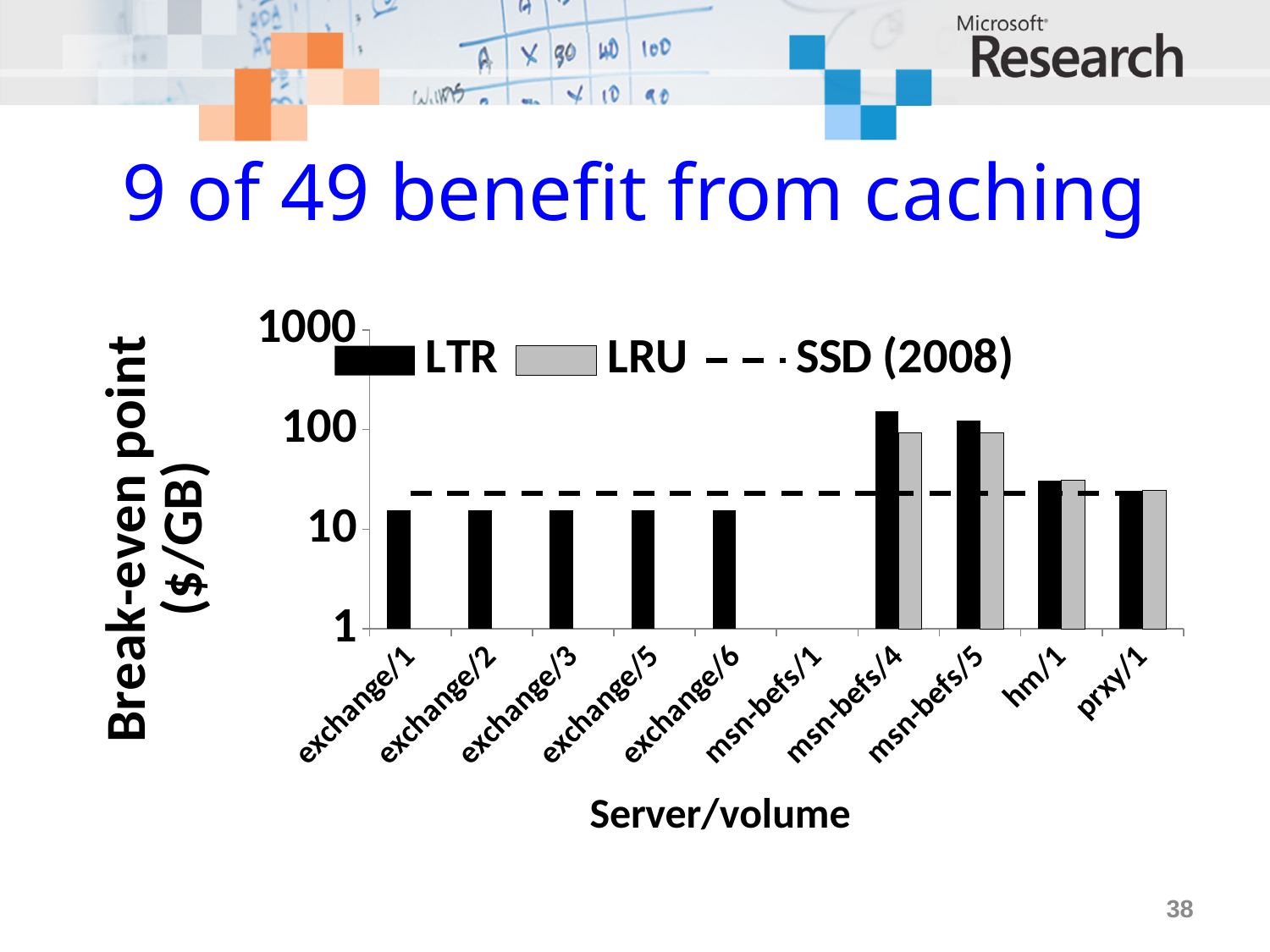
What is the title of the slide containing the chart? 9 of 49 benefit from caching Is the LTR value for msn-befs/4 greater or less than 100? greater How many server/volume categories are shown on the x axis? 10 What kind of chart is shown on the slide? combination bar and line chart Which has the larger LTR value, msn-befs/4 or hm/1? msn-befs/4 Which is larger for msn-befs/4, the LTR value or the LRU value? LTR Is the LTR value for hm/1 greater or less than 100? less How many entries does the legend list? 3 Is the LTR value for exchange/1 greater or less than 10? greater What is the label of the y axis? Break-even point ($/GB) Which server/volume has the highest LTR break-even point? msn-befs/4